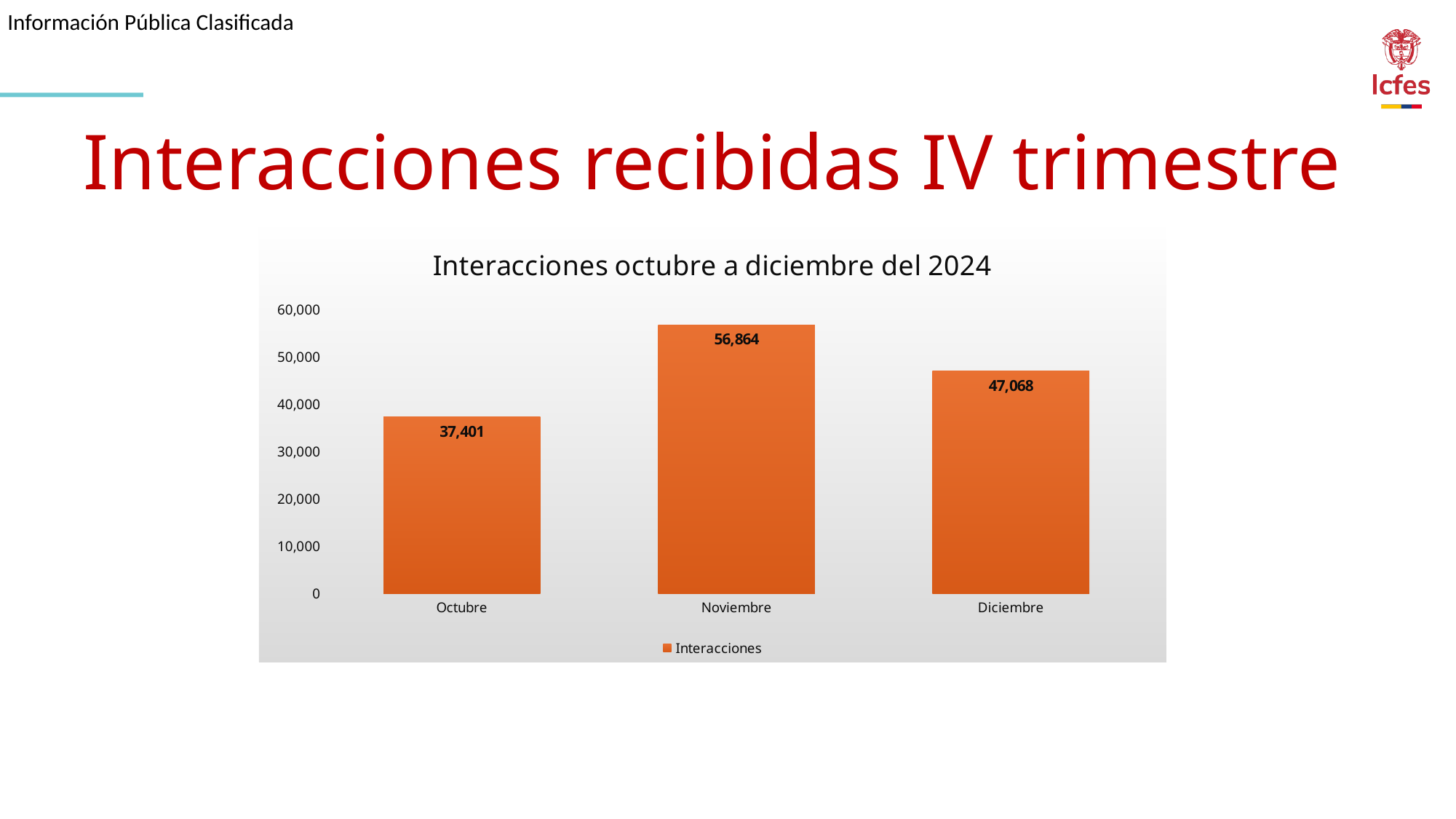
What is the value for Octubre? 37,401 What is the difference between the values for Noviembre and Octubre? 19,463 Which is larger, the value for Diciembre or the value for Octubre? Diciembre What is the title of the chart? Interacciones octubre a diciembre del 2024 Which month has the lowest number of interactions? Octubre What kind of chart is shown on the slide? bar chart Is the value for Octubre greater or less than 40,000? less What is the value for Diciembre? 47,068 What is the value for Noviembre? 56,864 How many categories are shown on the x axis? 3 Which month has the highest number of interactions? Noviembre What is the difference between the values for Noviembre and Diciembre? 9,796